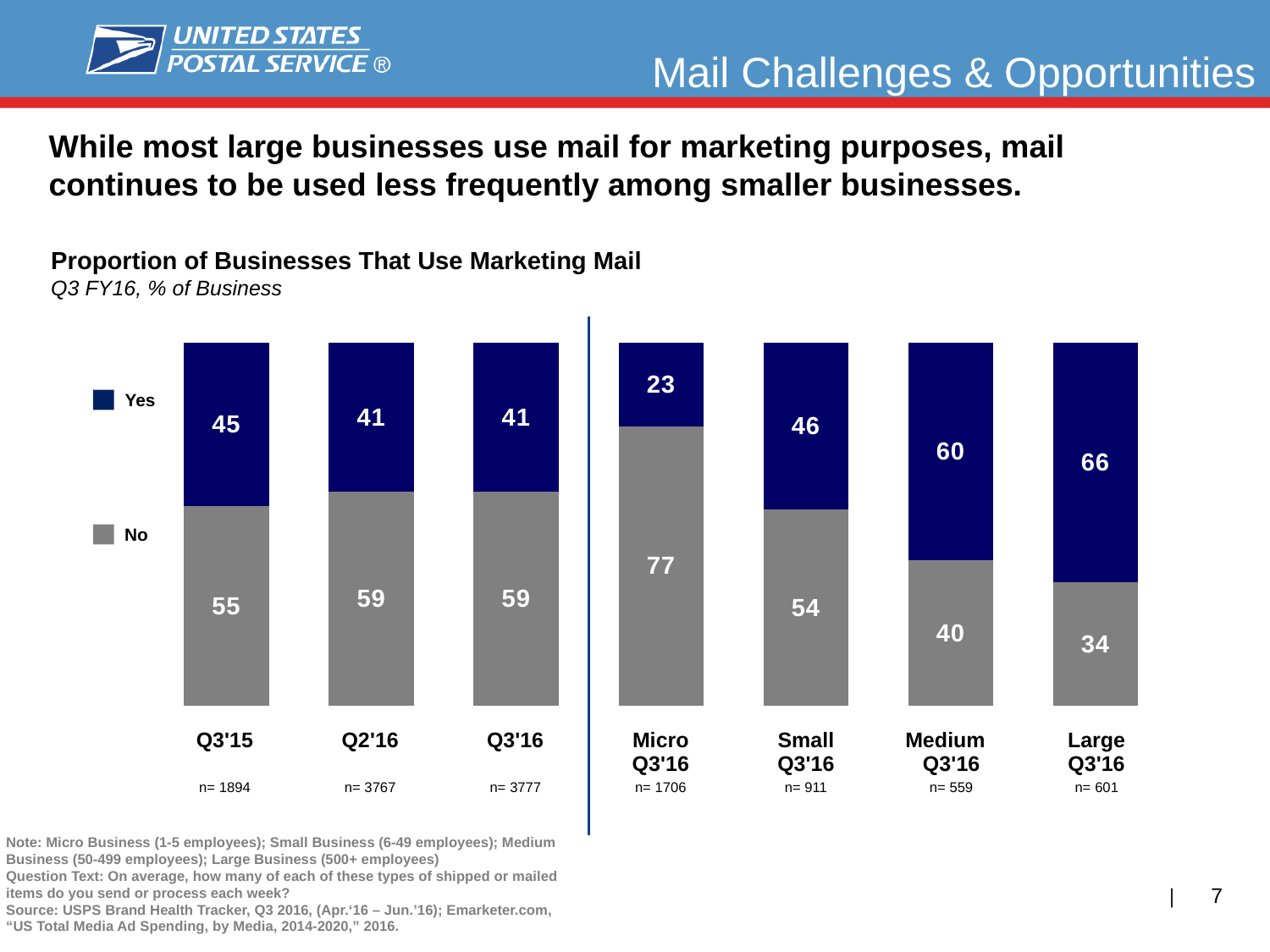
Which category has the lowest "Yes" value? Micro Q3'16 What is the "No" value for Micro businesses in Q3'16? 77 What is the total of the stacked bar for Q2'16? 100 Across the three time periods Q3'15, Q2'16 and Q3'16, does the "Yes" value rise or fall? Fall Which business size category has the highest "Yes" value? Large Q3'16 What kind of chart is shown on the slide? Stacked bar chart What is the "Yes" value for Medium businesses in Q3'16? 60 What percentage of businesses answered "Yes" to using marketing mail in Q3'15? 45 Is the "No" value larger for Small Q3'16 or for Medium Q3'16? Small Q3'16 How many bars (categories) are shown in the chart? 7 What is the difference between the "Yes" values for Large Q3'16 and Micro Q3'16? 43 How many series does the legend list? 2